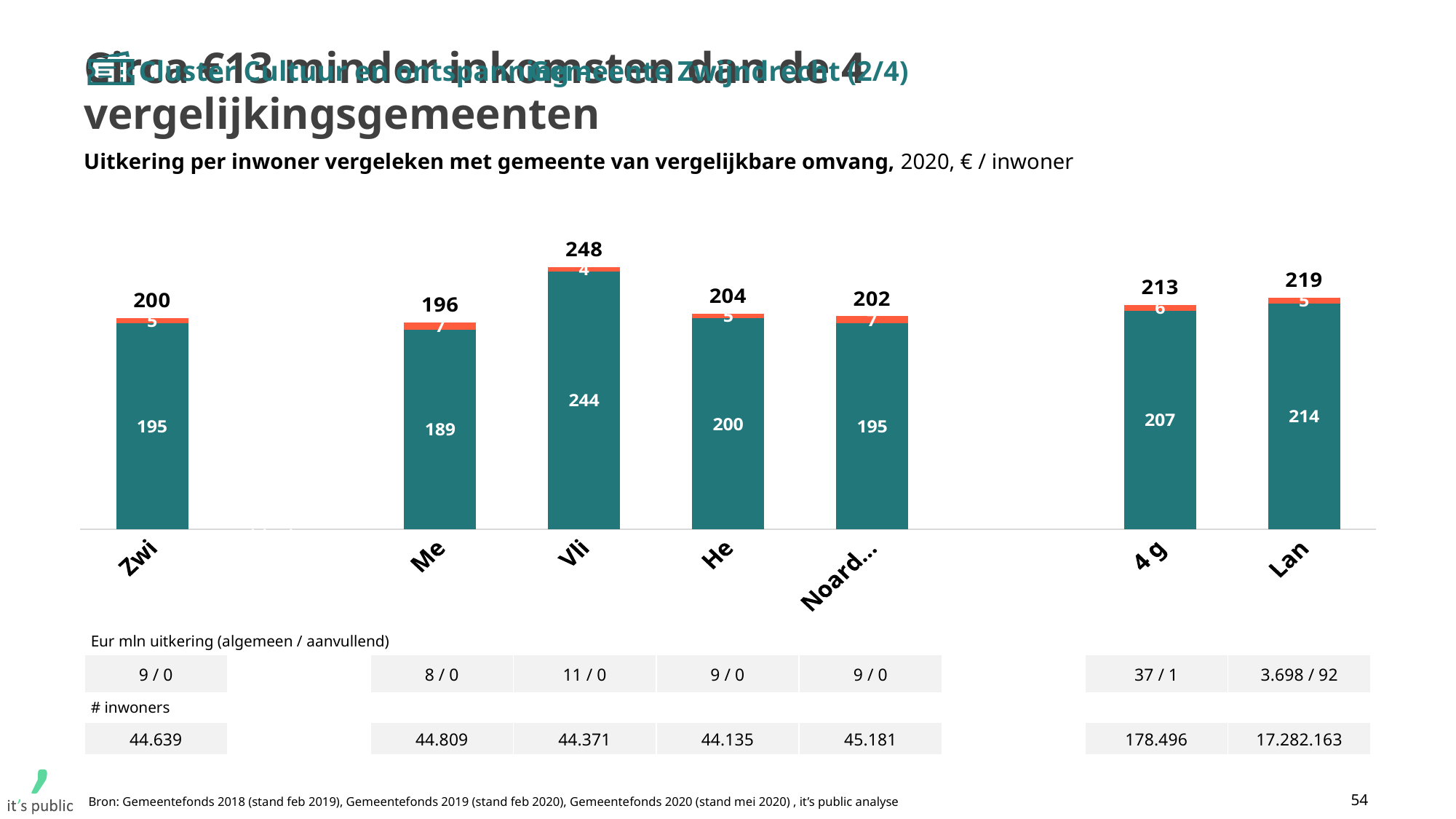
How many categories (bars) are shown in the chart? 7 Which category has the lowest total value? Me What is the total value shown above the bar for Vli? 248 What is the total of the stacked bar for 4 g? 213 According to the subtitle, in what unit are the values expressed? € / inwoner What kind of chart is shown on the slide? Stacked bar chart What is the value of the large teal segment of the bar for Noard...? 195 What is the value of the large teal segment of the bar for Lan? 214 Which category has the highest total value? Vli Which has a larger total value, Lan or 4 g? Lan What is the difference between the total for Vli and the total for Zwi? 48 What is the difference between the total for Lan and the total for 4 g? 6